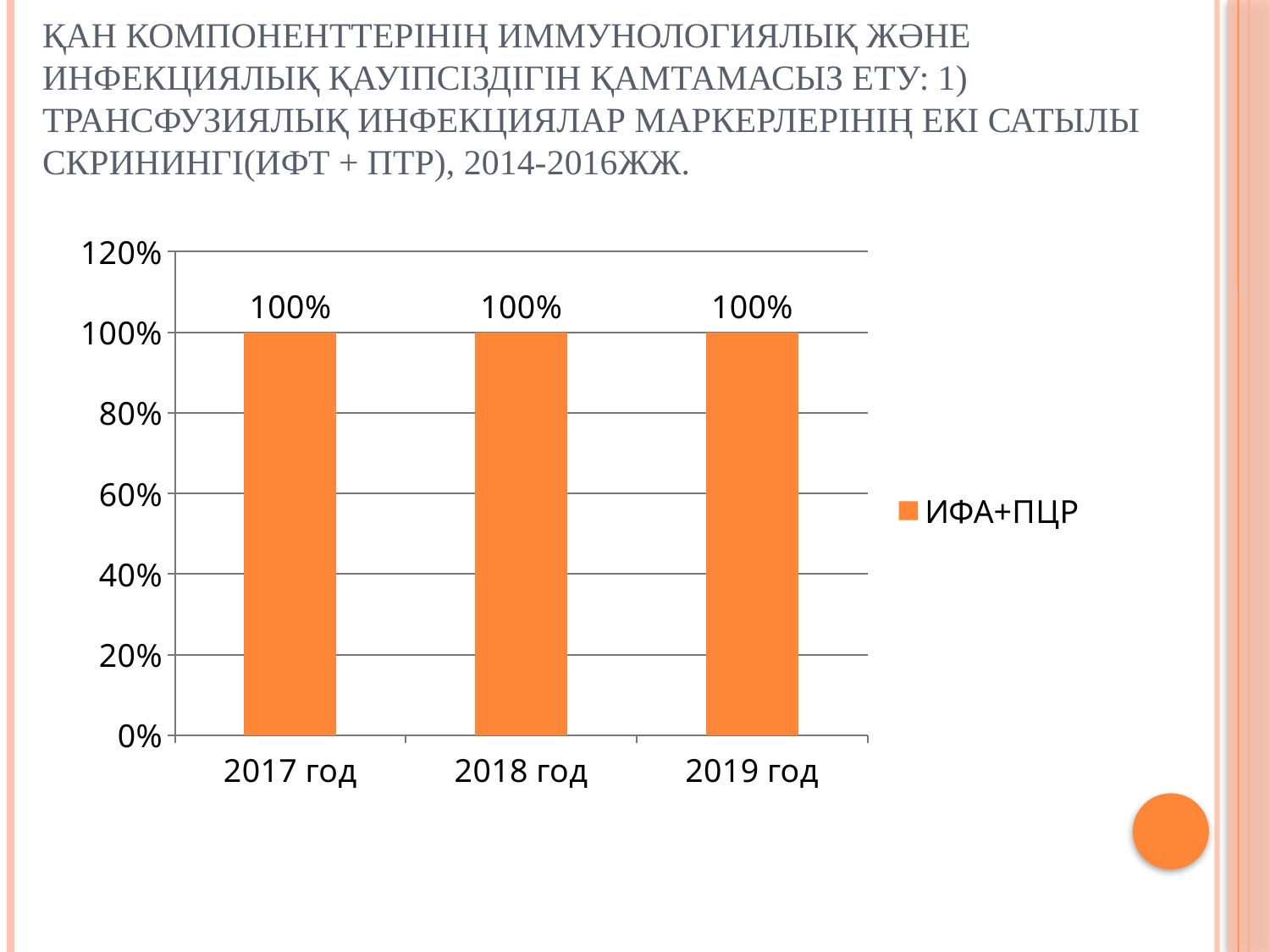
What kind of chart is shown on the slide? bar chart What is the value for 2018 год? 100% What is the difference between the values for 2017 год and 2019 год? 0% How many categories are shown on the x axis? 3 Is the value for 2018 год greater or less than 80%? greater What is the name of the series listed in the legend? ИФА+ПЦР How many series does the legend list? 1 What is the highest value shown on the y axis? 120% Do the values rise, fall or stay the same from 2017 год to 2019 год? stay the same Is the value for 2019 год greater or less than 120%? less What is the value for 2017 год? 100% What is the value for 2019 год? 100%